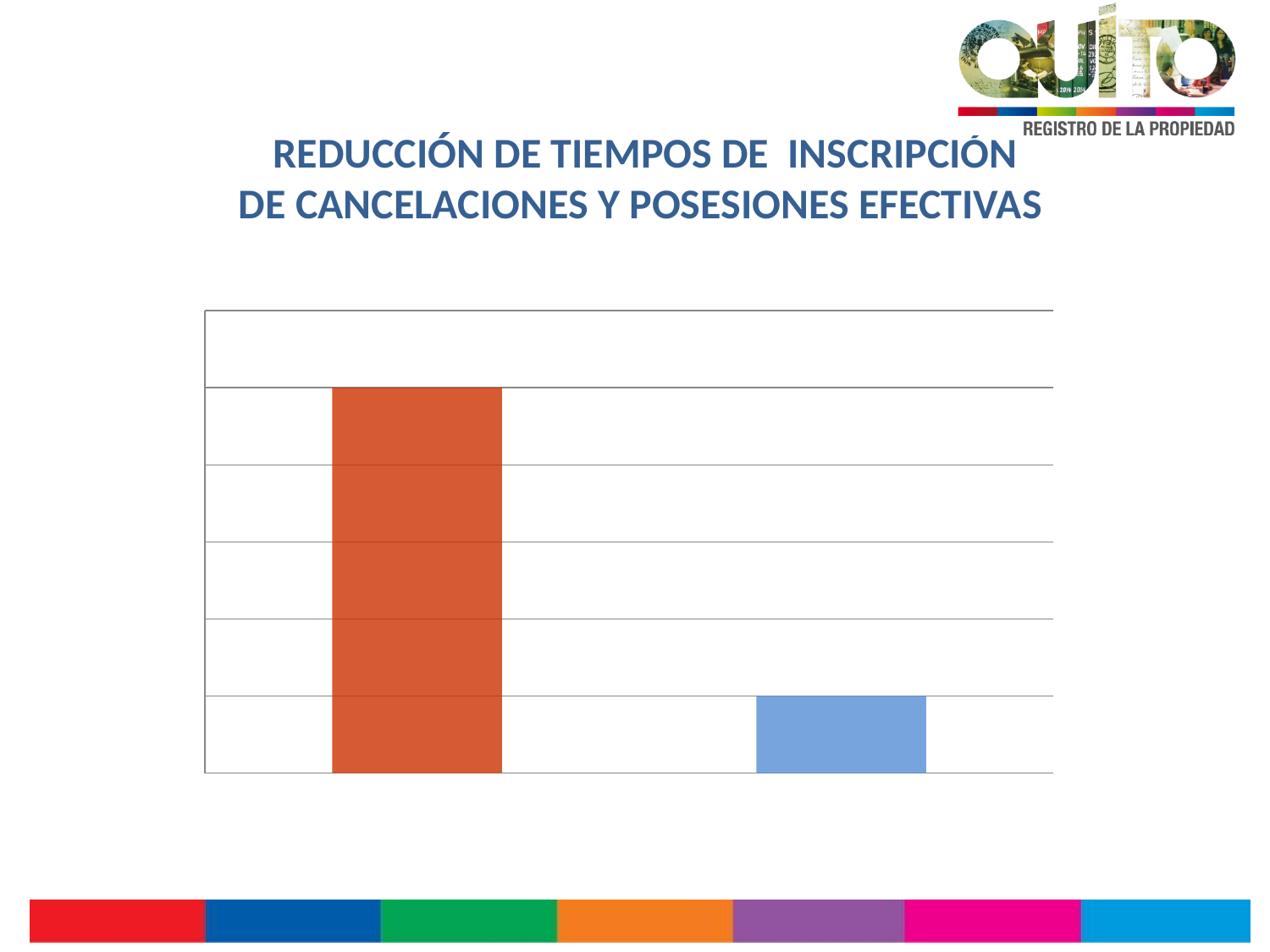
What is the title shown above the chart on the slide? REDUCCIÓN DE TIEMPOS DE INSCRIPCIÓN DE CANCELACIONES Y POSESIONES EFECTIVAS What colour is the bar on the right of the chart? blue Which bar in the chart is the shortest? the blue bar on the right Which bar in the chart is the tallest? the orange bar on the left What kind of chart is shown on the slide? bar chart Do the bars get taller or shorter from left to right? shorter How many bars are plotted in the chart? 2 Which bar is taller, the orange bar on the left or the blue bar on the right? the orange bar on the left